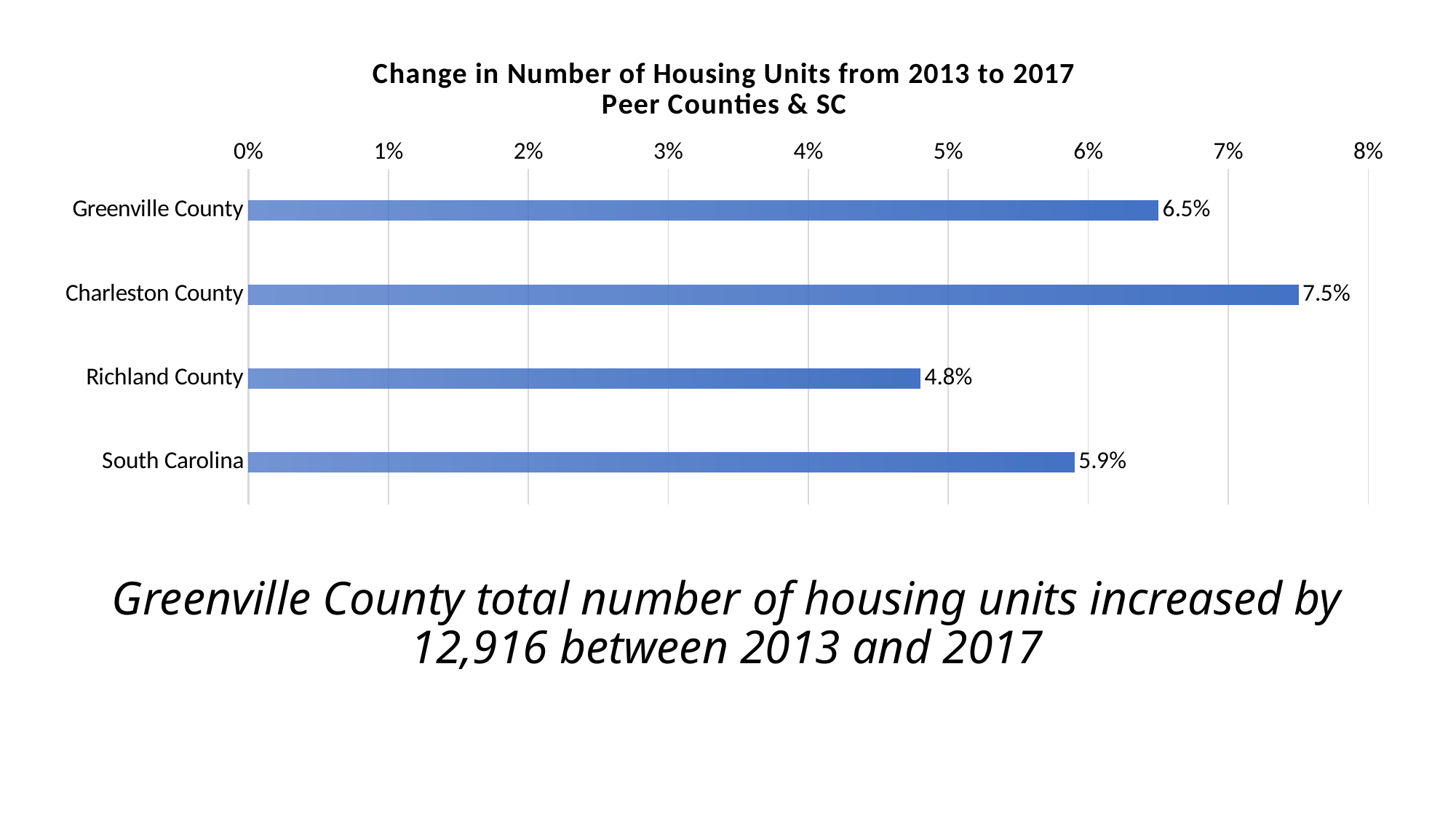
What is the difference between Charleston County's and Greenville County's change in housing units? 1.0% What is the change in number of housing units for South Carolina? 5.9% What kind of chart is shown on the slide? Bar chart What is the change in number of housing units for Richland County? 4.8% Which category has the lowest change in number of housing units? Richland County Which category has the highest change in number of housing units? Charleston County What is the change in number of housing units for Greenville County? 6.5% What is the difference between Greenville County's and Richland County's change in housing units? 1.7% Is the value for Richland County greater or less than 5%? less Which is larger, the value for Greenville County or the value for South Carolina? Greenville County How many categories are shown in the chart? 4 What is the change in number of housing units for Charleston County? 7.5%